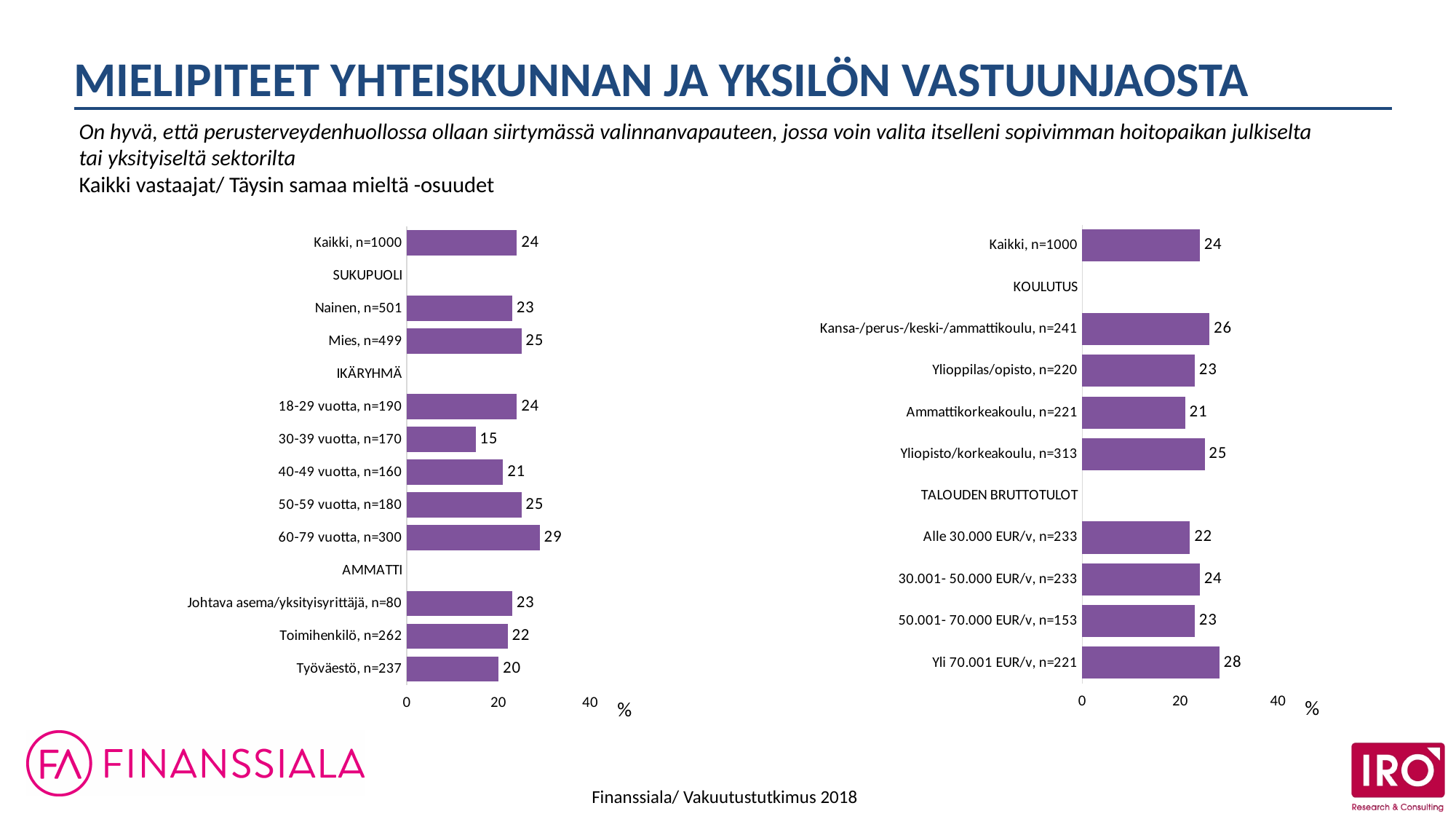
In the left chart, what is the difference between the values for Mies, n=499 and Nainen, n=501? 2 In the right chart, which category has the lowest value? Ammattikorkeakoulu, n=221 In the left chart, what is the value for 60-79 vuotta, n=300? 29 What type of chart is the left chart? Bar chart In the right chart, what is the value for Yli 70.001 EUR/v, n=221? 28 In the left chart, which category has the lowest value? 30-39 vuotta, n=170 In the left chart, what is the value for 30-39 vuotta, n=170? 15 How many bars are plotted in the right chart? 9 In the right chart, which is larger: the value for Kansa-/perus-/keski-/ammattikoulu, n=241 or Ylioppilas/opisto, n=220? Kansa-/perus-/keski-/ammattikoulu, n=241 In the right chart, what is the value for Ammattikorkeakoulu, n=221? 21 In the left chart, which category has the highest value? 60-79 vuotta, n=300 In the right chart, which category has the highest value? Yli 70.001 EUR/v, n=221